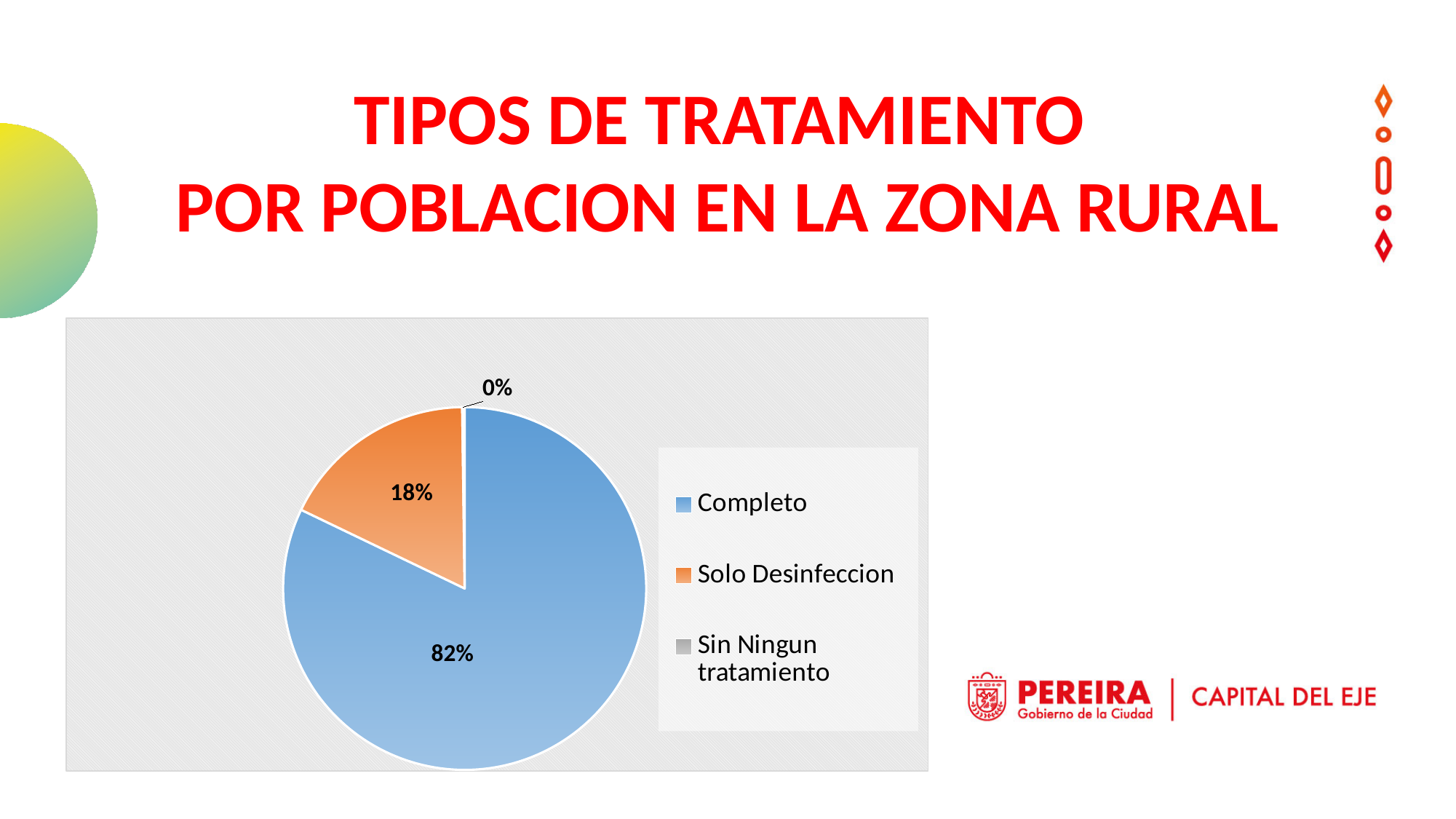
What share of the pie does Completo represent? 82% What is the title of the slide containing the chart? TIPOS DE TRATAMIENTO POR POBLACION EN LA ZONA RURAL What kind of chart is shown on the slide? pie chart Which category has the largest slice of the pie? Completo What colour is the slice for Solo Desinfeccion? orange What is the difference in percentage points between Completo and Solo Desinfeccion? 64 What share of the pie does Solo Desinfeccion represent? 18% Which category has the smallest slice of the pie? Sin Ningun tratamiento Which is larger, the share for Completo or the share for Solo Desinfeccion? Completo What share of the pie does Sin Ningun tratamiento represent? 0% How many categories does the legend list? 3